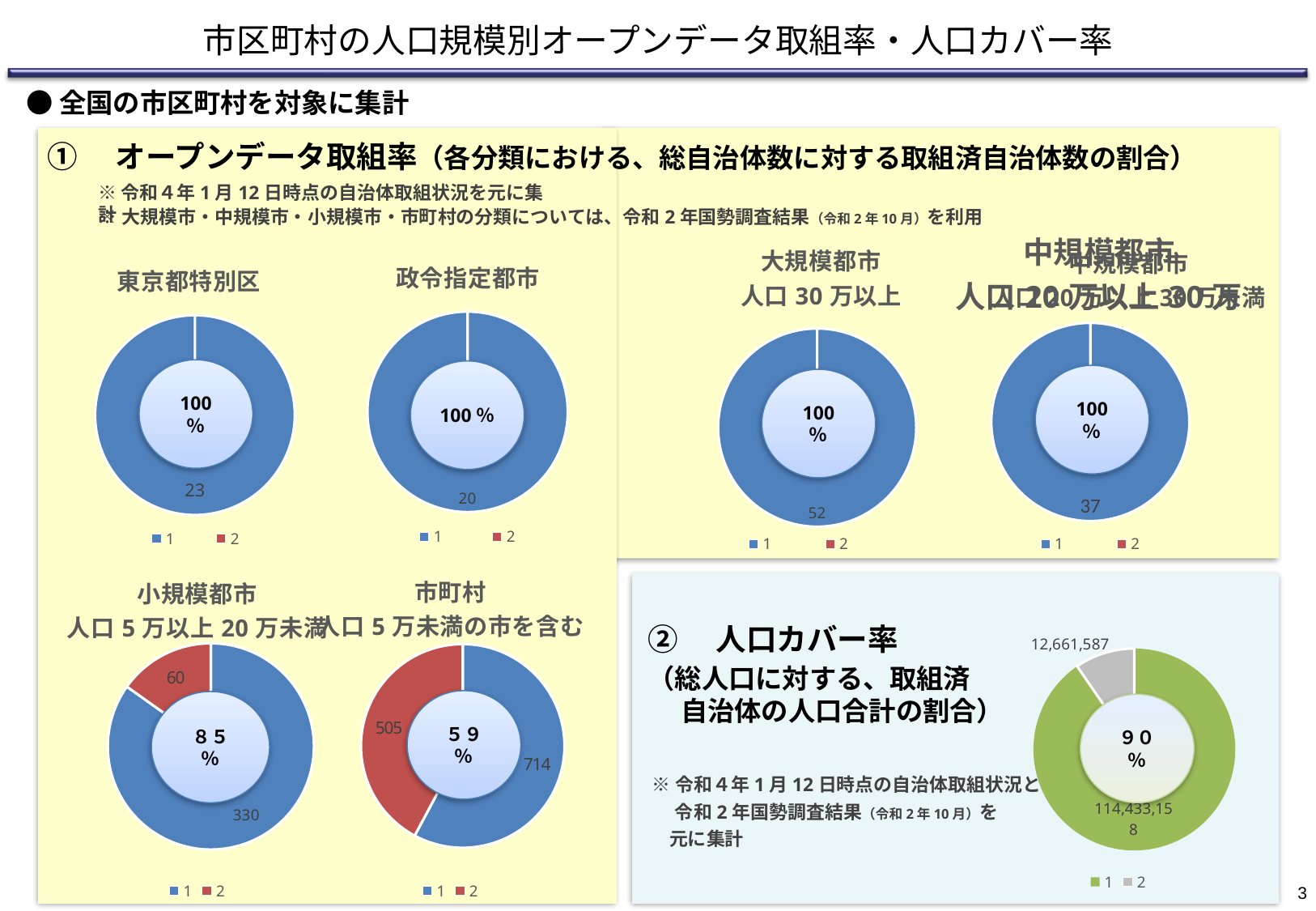
In the 人口カバー率 chart, what is the data label for the grey series 2 slice? 12,661,587 In the 小規模都市 人口5万以上20万未満 chart, what is the total of the two slices (330 and 60)? 390 In the 政令指定都市 chart, what is the data label shown for series 1? 20 How many series does the legend of the 人口カバー率 chart list? 2 In the 市町村 chart, which slice is larger, series 1 (714) or series 2 (505)? Series 1 (714) What kind of chart is used for 東京都特別区? Donut (pie) chart In the 小規模都市 人口5万以上20万未満 chart, what is the value of the red series 2 slice? 60 In the 中規模都市 chart, what is the data label shown for series 1? 37 What percentage is shown in the centre of the 市町村 chart? 59% In the 東京都特別区 chart, what is the data label shown for series 1? 23 In the 市町村 chart, what is the difference between the series 1 value (714) and the series 2 value (505)? 209 In the 大規模都市 人口30万以上 chart, what is the data label shown for series 1? 52